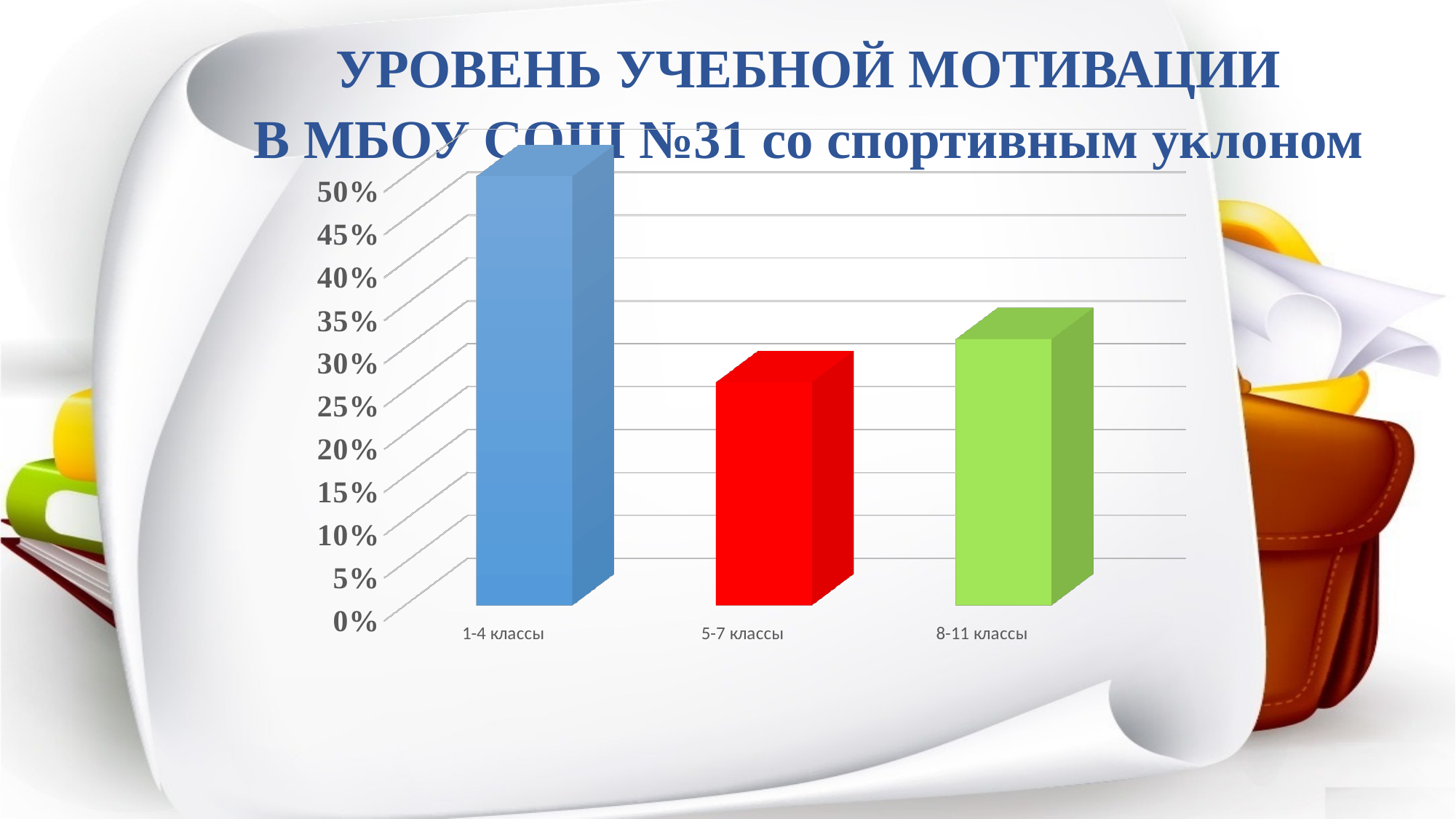
Which is larger, the value for 5-7 классы or the value for 8-11 классы? 8-11 классы How many categories are shown on the x axis of the chart? 3 Is the value for 1-4 классы greater or less than 45%? greater Is the value for 8-11 классы greater or less than 40%? less What is the title of the slide containing the chart? УРОВЕНЬ УЧЕБНОЙ МОТИВАЦИИ В МБОУ СОШ №31 со спортивным уклоном Is the value for 5-7 классы greater or less than 20%? greater Which category has the highest value in the chart? 1-4 классы Which category has the lowest value in the chart? 5-7 классы Which is larger, the value for 1-4 классы or the value for 8-11 классы? 1-4 классы What kind of chart is shown on the slide? bar chart